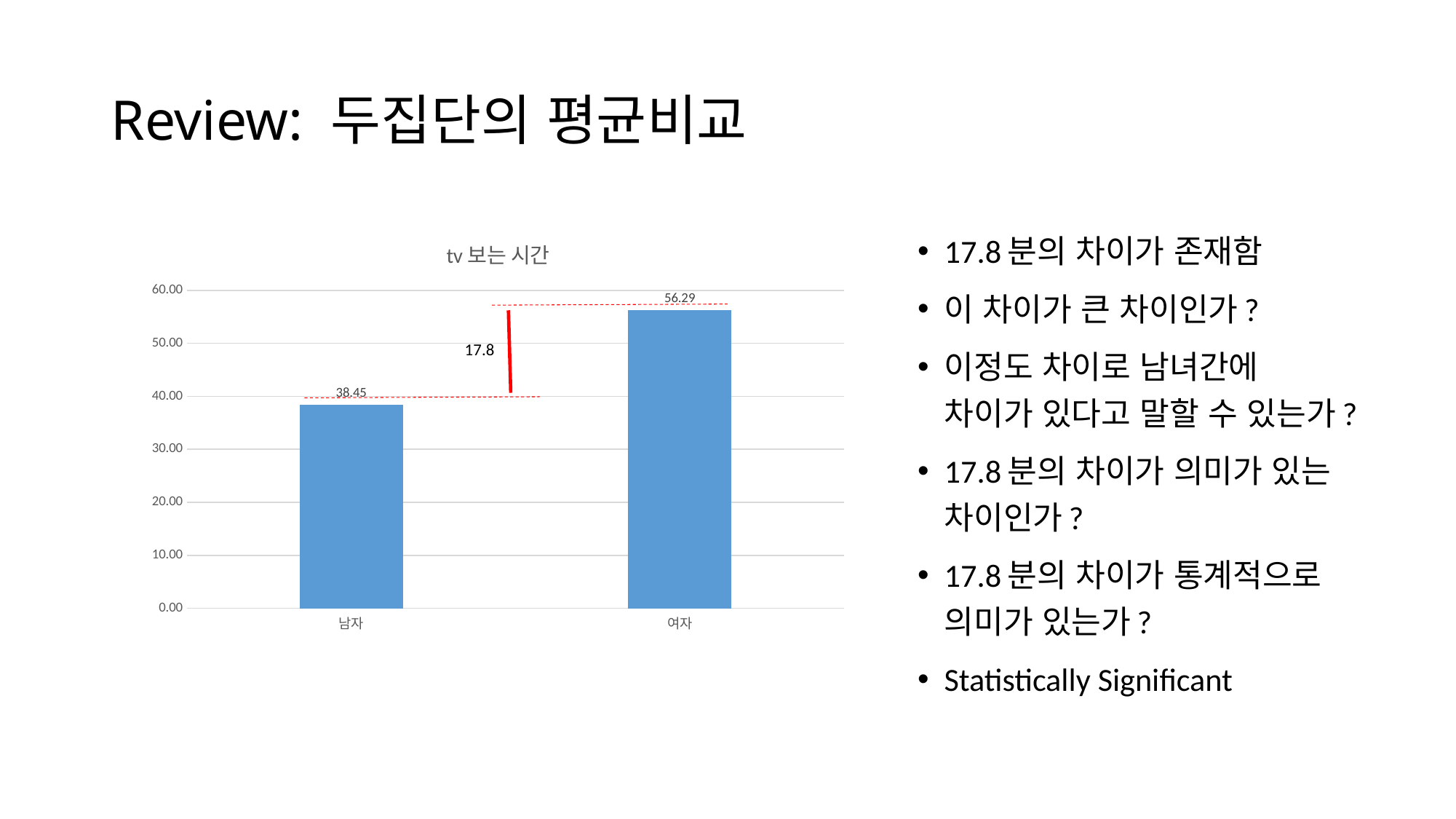
Which category has the highest value in the tv 보는 시간 chart? 여자 What is the title of the chart on the slide? tv 보는 시간 Is the value for 남자 in the tv 보는 시간 chart greater or less than 40.00? less What kind of chart is the tv 보는 시간 chart? bar chart How many categories are shown in the tv 보는 시간 chart? 2 Is the value for 여자 in the tv 보는 시간 chart greater or less than 50.00? greater What is the difference between the values for 여자 and 남자 in the tv 보는 시간 chart? 17.84 Which is larger in the tv 보는 시간 chart, the value for 남자 or the value for 여자? 여자 Which category has the lowest value in the tv 보는 시간 chart? 남자 What difference value is annotated in red between the two bars in the tv 보는 시간 chart? 17.8 What is the value for 여자 in the tv 보는 시간 chart? 56.29 What is the value for 남자 in the tv 보는 시간 chart? 38.45